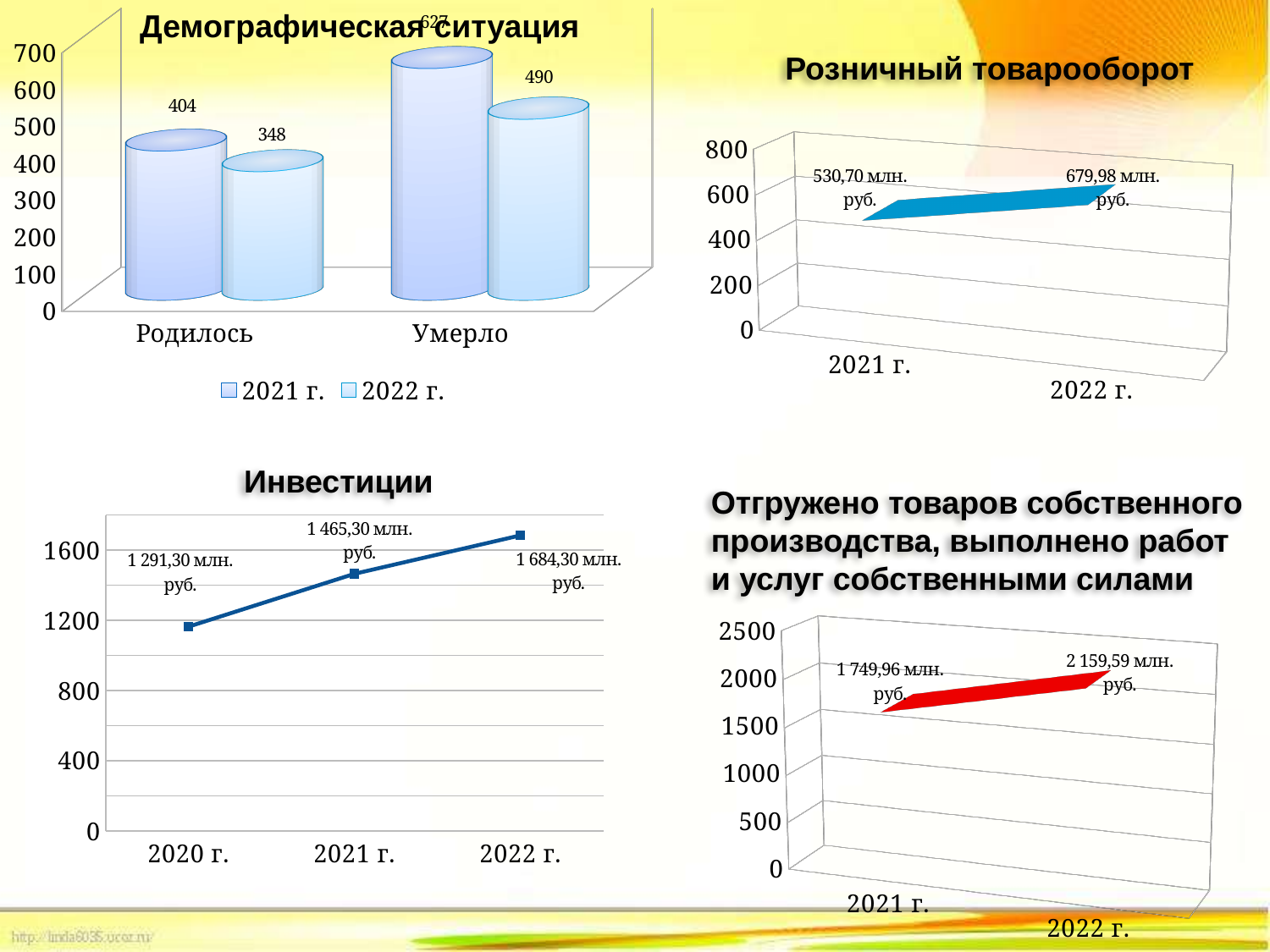
In the 'Розничный товарооборот' chart, which year has the lower value? 2021 г. In the 'Инвестиции' chart, do the values rise or fall from 2020 г. to 2022 г.? rise In the 'Демографическая ситуация' chart, what is the difference between Родилось in 2021 г. and Родилось in 2022 г.? 56 In the 'Отгружено товаров собственного производства' chart, what is the value for 2021 г.? 1 749,96 млн. руб. In the 'Инвестиции' chart, what is the value for 2020 г.? 1 291,30 млн. руб. In the 'Отгружено товаров собственного производства' chart, which year has the higher value? 2022 г. In the 'Демографическая ситуация' chart, what is the value for Умерло in 2022 г.? 490 In the 'Демографическая ситуация' chart, how many series does the legend list? 2 In the 'Розничный товарооборот' chart, what is the value for 2022 г.? 679,98 млн. руб. In the 'Демографическая ситуация' chart, what is the value for Родилось in 2021 г.? 404 In the 'Демографическая ситуация' chart, is the value for Умерло in 2021 г. greater or less than 600? greater What kind of chart is the 'Инвестиции' chart? line chart